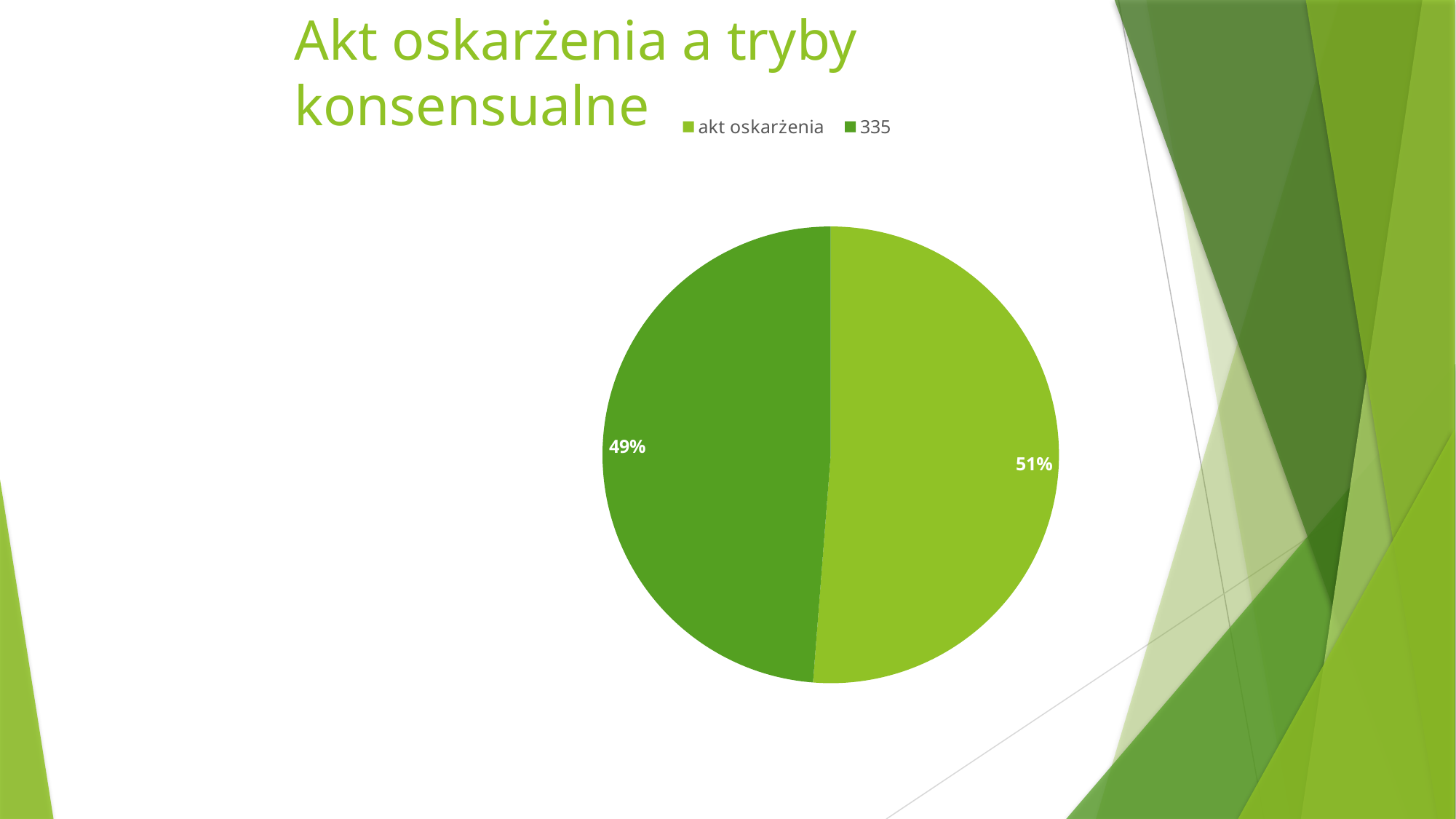
What is the title of the slide containing the pie chart? Akt oskarżenia a tryby konsensualne What share of the pie does the "akt oskarżenia" slice represent? 51% How many entries does the legend list? 2 What is the difference in percentage points between the "akt oskarżenia" slice and the "335" slice? 2 percentage points Which slice is larger, "akt oskarżenia" or "335"? akt oskarżenia What share of the pie does the "335" slice represent? 49% How many slices does the pie chart have? 2 Which legend entry is shown in the darker green colour? 335 Which slice of the pie is the smallest? 335 Which slice of the pie is the largest? akt oskarżenia What kind of chart is shown on the slide? pie chart